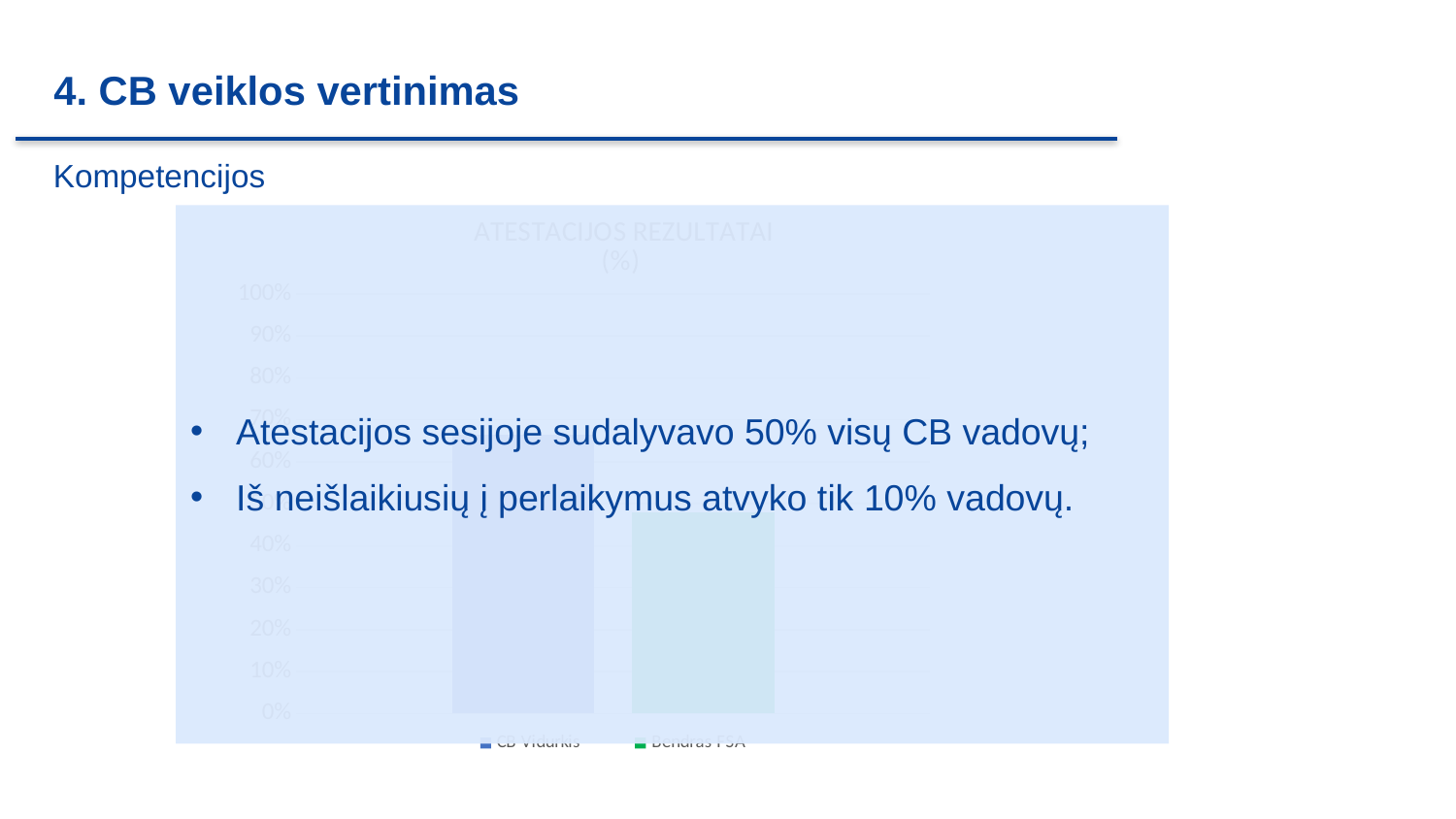
What is the title of the chart? ATESTACIJOS REZULTATAI (%) What kind of chart is shown on the slide? bar chart What is the highest value shown on the chart's vertical axis? 100% How many bars are plotted in the chart? 2 How many series does the chart legend list? 2 Is the value for CB vidurkis greater or less than 50%? greater